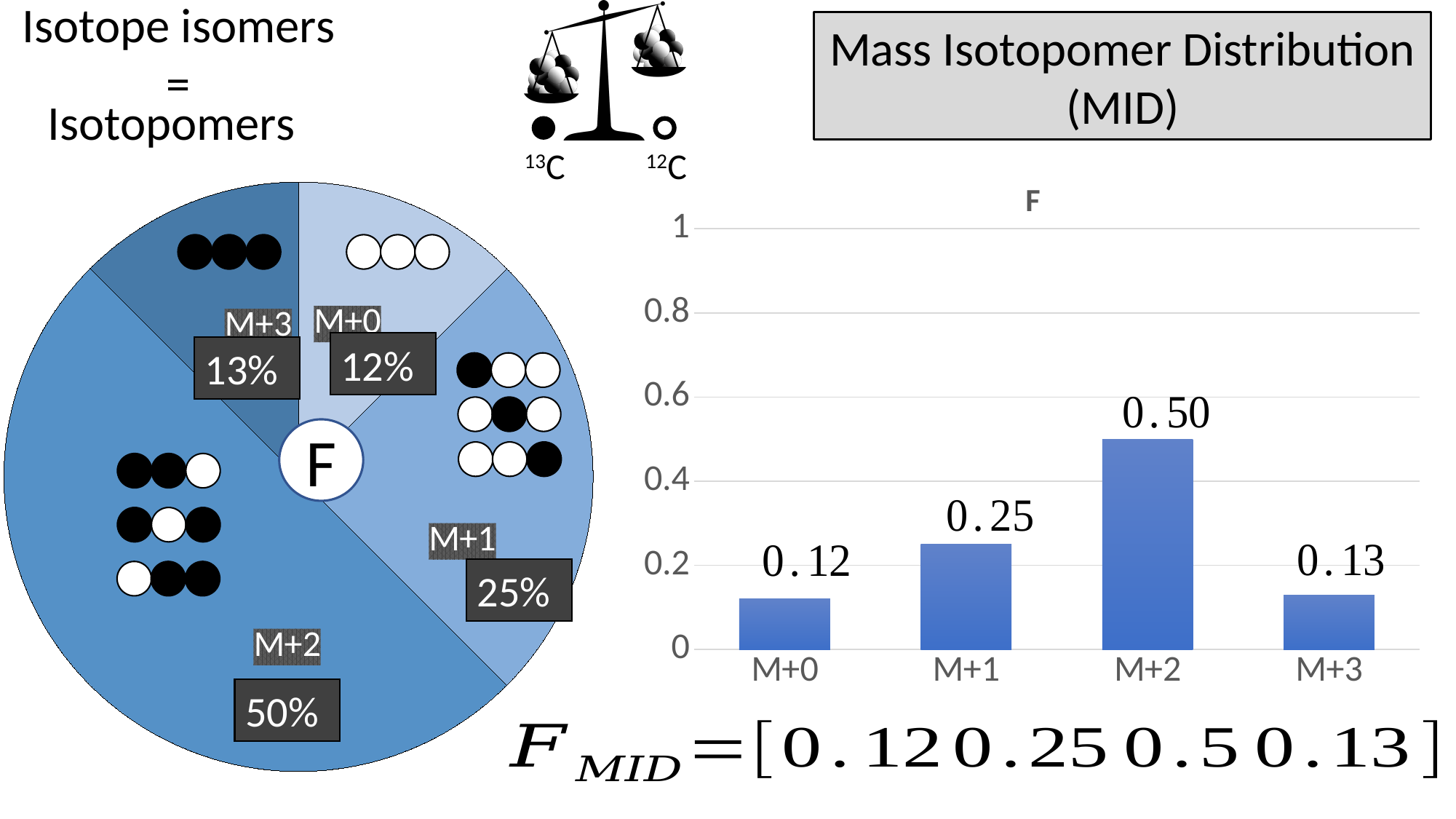
In the bar chart on the right, which category has the highest value? M+2 In the pie chart on the left, what share does the M+2 slice have? 50% What kind of chart is the chart on the right of the slide? bar chart In the bar chart on the right, which category has the lowest value? M+0 In the bar chart on the right, is the value for M+1 greater or less than 0.2? greater In the bar chart on the right, what is the value for M+0? 0.12 In the bar chart on the right, what is the value for M+2? 0.50 In the pie chart on the left, which slice is larger, M+1 or M+3? M+1 How many categories are shown on the x axis of the bar chart on the right? 4 How many slices does the pie chart on the left have? 4 In the bar chart on the right, what is the difference between the values for M+2 and M+1? 0.25 What is the title of the bar chart on the right? F